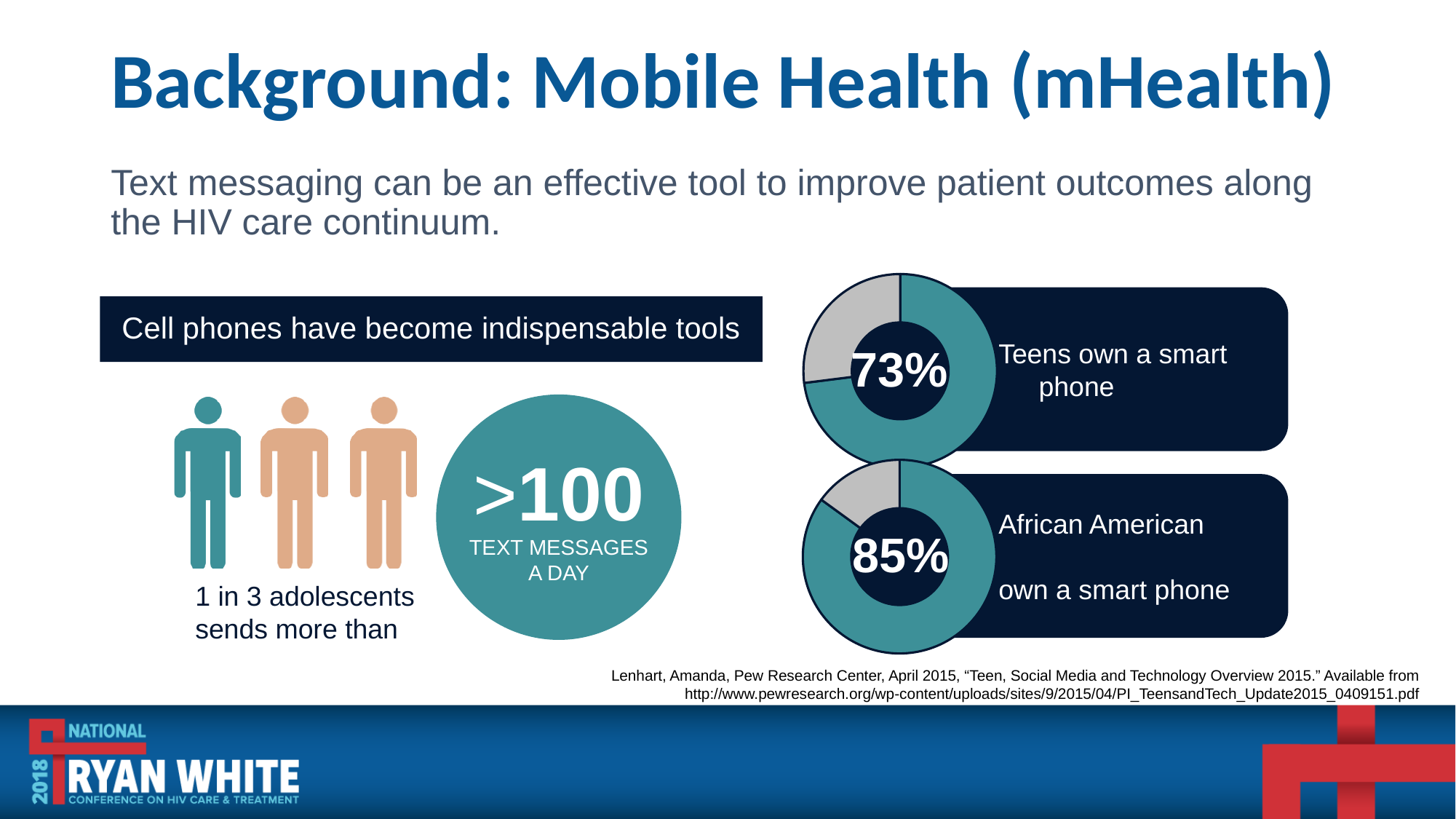
In the top donut chart, what share of the ring is not filled (the grey portion)? 27% What colour is used for the filled portion of the donut charts? teal Which group shows the higher smart phone ownership, teens overall or African Americans? African Americans How many donut charts are on the slide? 2 Which of the two donut charts shows the lower percentage? Teens own a smart phone (73%) What is the heading of the dark banner above the infographic on the left? Cell phones have become indispensable tools In the bottom donut chart, what share of the ring is grey? 15% In the bottom donut chart, what percentage of African Americans own a smart phone? 85% What is the difference in percentage points between African American smart phone ownership and teen smart phone ownership? 12 percentage points According to the infographic on the left, how many text messages a day does 1 in 3 adolescents send? >100 In the top donut chart, what percentage of teens own a smart phone? 73% What kind of charts are shown on the right side of the slide? donut charts